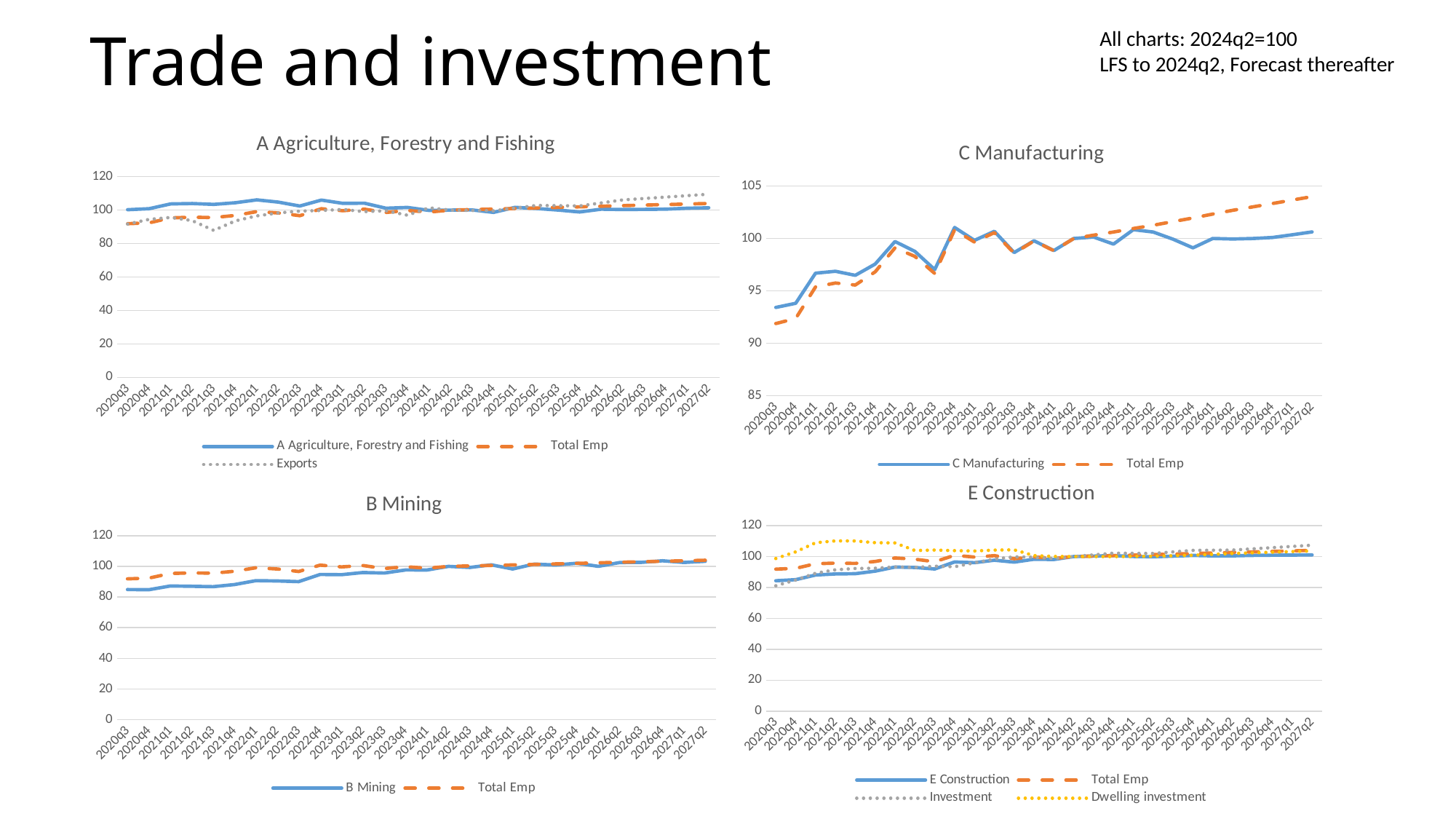
In the C Manufacturing chart, is the value of the C Manufacturing series at 2020q3 greater or less than 95? less What is the title of the top-left chart? A Agriculture, Forestry and Fishing Which series in the E Construction chart is drawn with a yellow dotted line? Dwelling investment In the B Mining chart, does the B Mining series generally rise or fall from 2020q3 to 2027q2? rise How many series does the legend of the C Manufacturing chart list? 2 How many series does the legend of the E Construction chart list? 4 How many series does the legend of the A Agriculture, Forestry and Fishing chart list? 3 In the E Construction chart, is the value of the Dwelling investment series at 2021q2 greater or less than 100? greater In the B Mining chart, is the value of the B Mining series at 2020q3 greater or less than 100? less What kind of chart is the B Mining chart? line chart How many quarters are shown on the x axis of the B Mining chart? 28